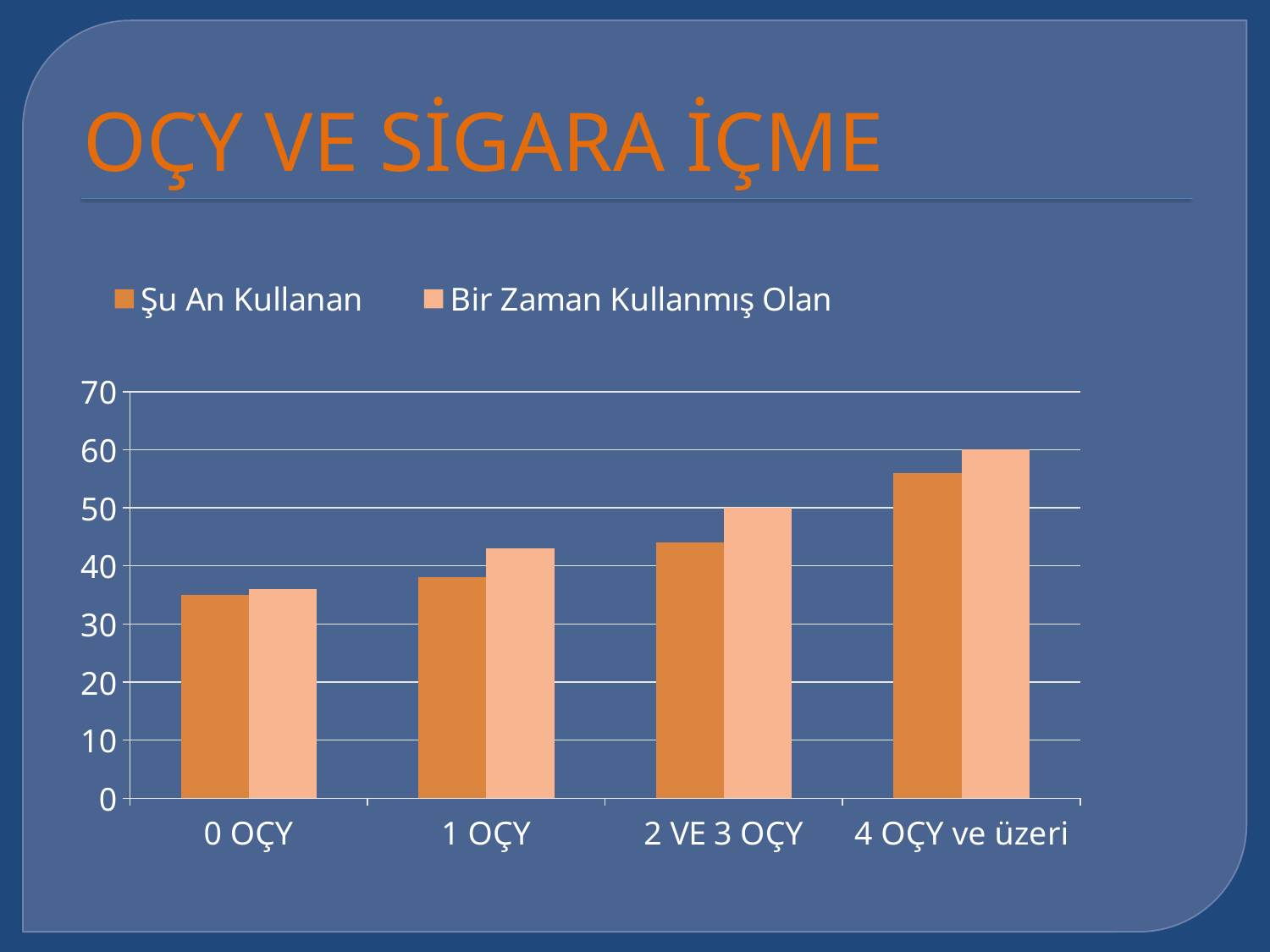
Which category has the lowest value for Bir Zaman Kullanmış Olan? 0 OÇY How many series does the legend list? 2 Which category has the highest value for Şu An Kullanan? 4 OÇY ve üzeri Which is larger at 1 OÇY: Şu An Kullanan or Bir Zaman Kullanmış Olan? Bir Zaman Kullanmış Olan Is the value for Şu An Kullanan at 2 VE 3 OÇY greater or less than 50? less What kind of chart is shown on the slide? bar chart Is the value for Şu An Kullanan at 4 OÇY ve üzeri greater or less than 50? greater Do the values for Bir Zaman Kullanmış Olan rise or fall from 0 OÇY to 4 OÇY ve üzeri? rise Is the value for Şu An Kullanan at 0 OÇY greater or less than 40? less How many categories are shown on the x axis? 4 What is the title of the slide containing the chart? OÇY VE SİGARA İÇME